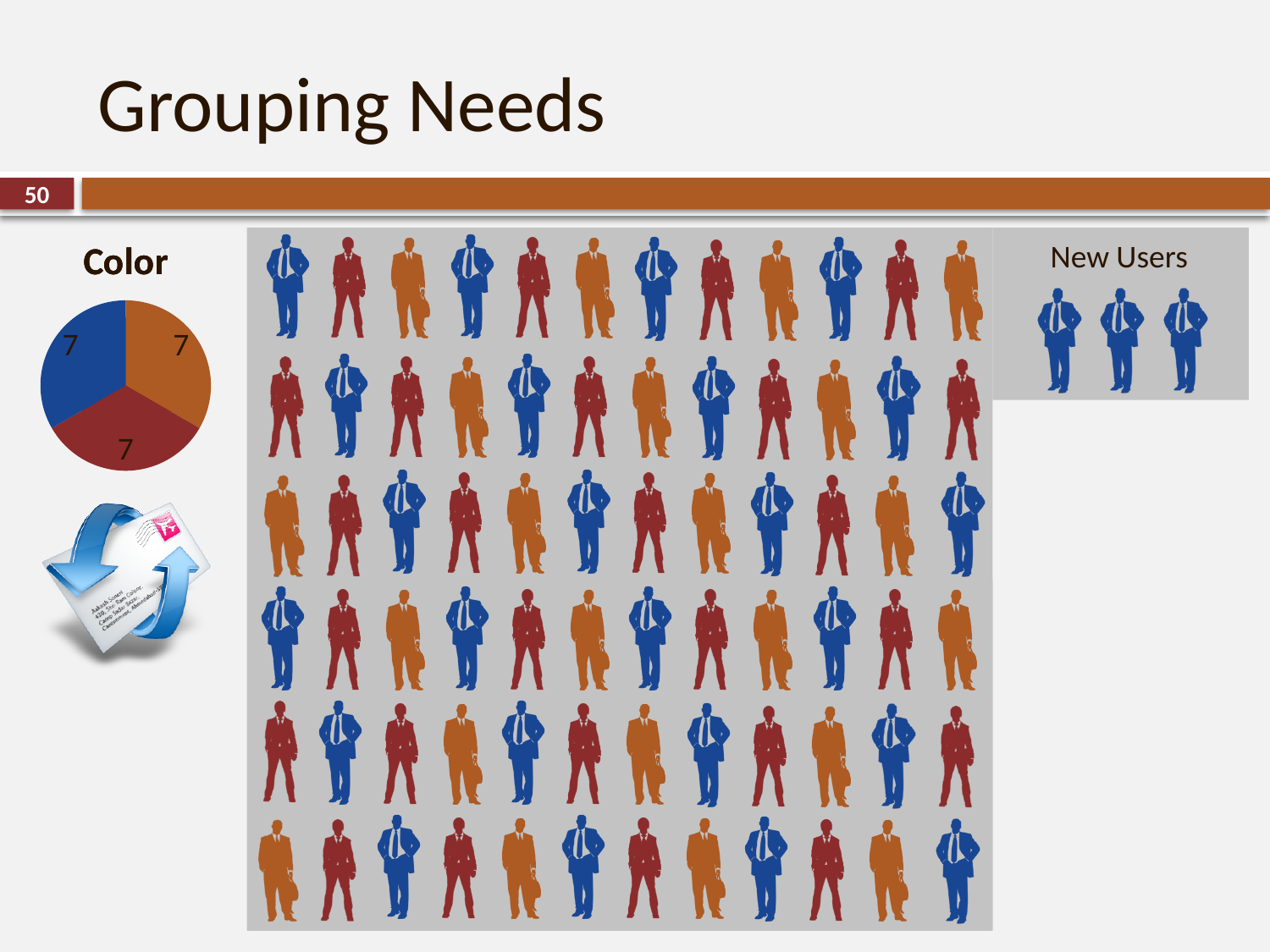
In the "Color" pie chart, what value is printed on the blue slice? 7 What is the title of the pie chart on the left of the slide? Color In the "Color" pie chart, is the value on the orange slice greater or less than 10? less In the "Color" pie chart, what is the total of the values printed on all slices? 21 How many slices does the "Color" pie chart have? 3 In the "Color" pie chart, do all three slices have the same value? yes In the "Color" pie chart, what value is printed on the red slice? 7 In the "Color" pie chart, what value is printed on the orange slice? 7 In the "Color" pie chart, what is the difference between the value on the blue slice and the value on the red slice? 0 What kind of chart is shown under the heading "Color"? pie chart